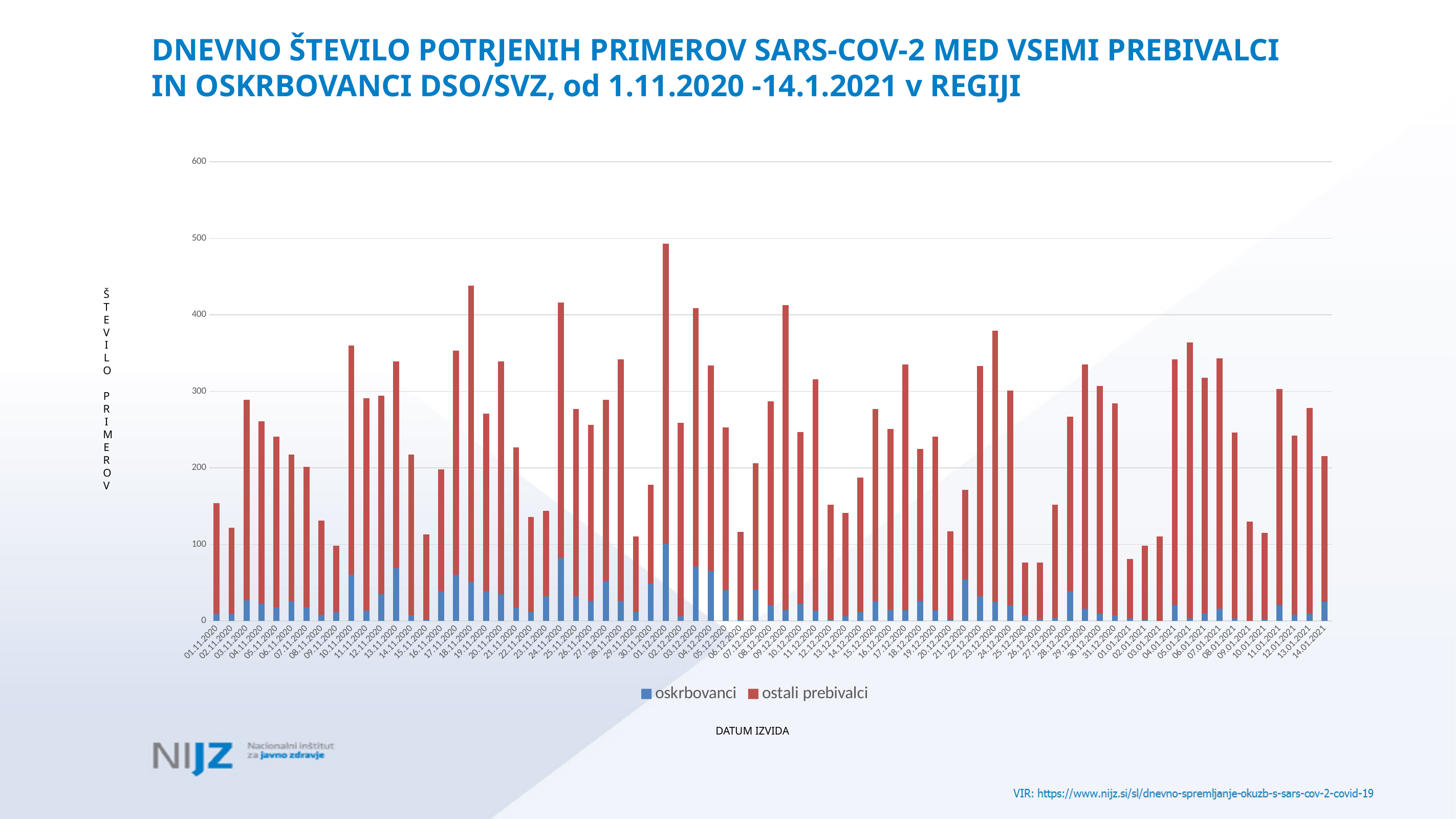
How many series does the legend list? 2 What are the two series named in the legend? oskrbovanci and ostali prebivalci Is the total value for 26.12.2020 greater or less than 100? less What is the label of the x axis? DATUM IZVIDA How many dates (categories) are plotted on the x axis? 75 Which date has the larger total, 02.12.2020 or 01.11.2020? 02.12.2020 Which date has the larger total, 18.11.2020 or 19.11.2020? 18.11.2020 Is the total value for 02.12.2020 greater or less than 400? less Is the total value for 01.11.2020 greater or less than 200? less What kind of chart is shown on the slide? bar chart On which date is the total number of cases highest? 01.12.2020